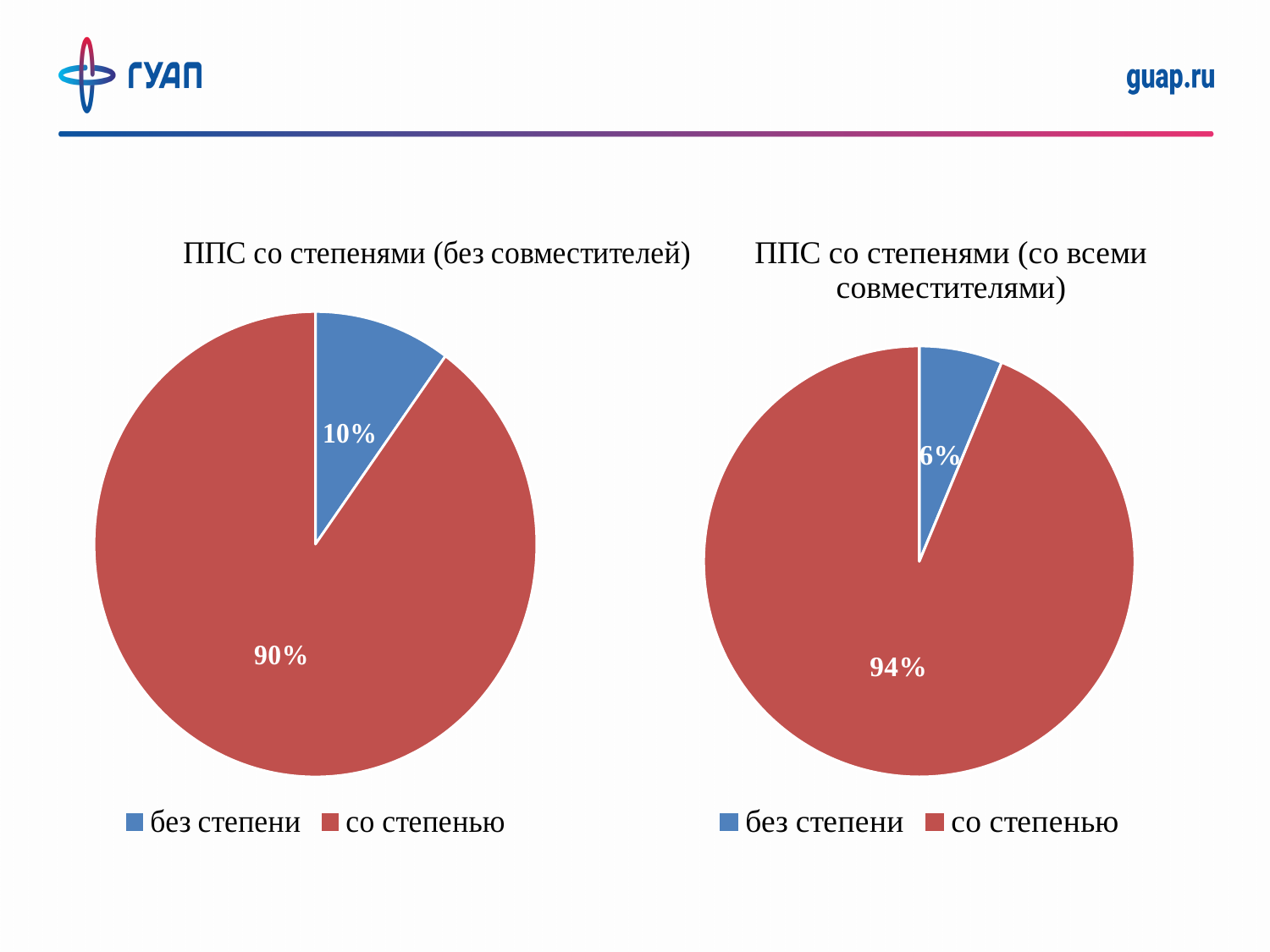
In the left chart, what is the difference between the shares of "со степенью" and "без степени"? 80% In the chart titled "ППС со степенями (без совместителей)", what share does "без степени" have? 10% In the chart titled "ППС со степенями (со всеми совместителями)", what share does "без степени" have? 6% In the right chart, which category has the smallest slice? без степени In the chart titled "ППС со степенями (без совместителей)", what share does "со степенью" have? 90% What type of chart is the chart titled "ППС со степенями (без совместителей)"? pie chart How many categories does the right chart's legend list? 2 Which chart shows a larger share for "без степени": the left chart or the right chart? the left chart In the chart titled "ППС со степенями (со всеми совместителями)", what share does "со степенью" have? 94% What is the title of the left chart? ППС со степенями (без совместителей) In the left chart, which category has the largest slice? со степенью In the right chart, what colour is the "со степенью" slice? red